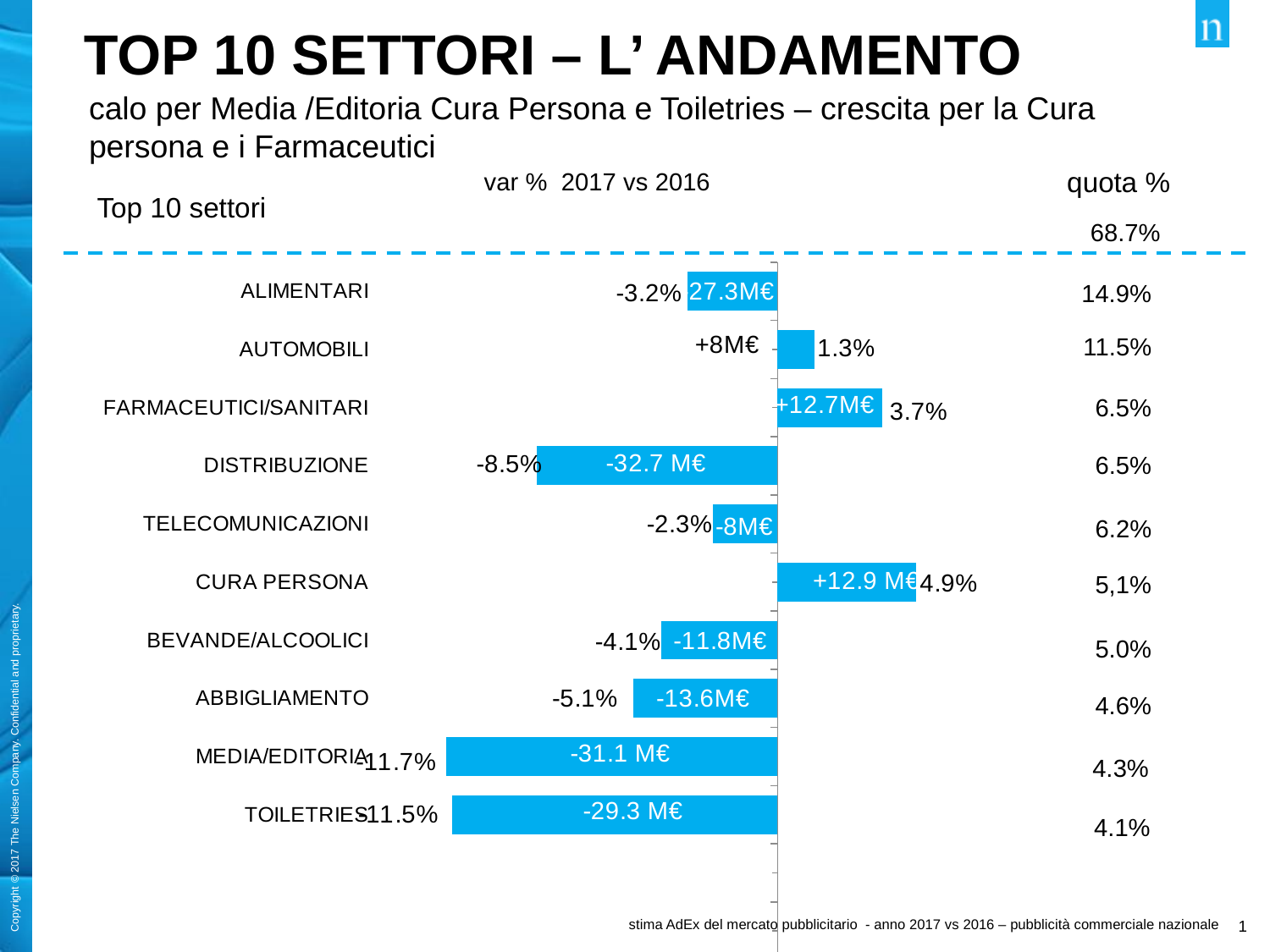
What is the variation in M€ shown for CURA PERSONA? +12.9 M€ Which sector has the highest quota %? ALIMENTARI What type of chart is used to show the variation by sector? bar chart What is the variation in M€ shown for FARMACEUTICI/SANITARI? +12.7M€ What is the variation in M€ shown for DISTRIBUZIONE? -32.7 M€ What is the quota % shown for TELECOMUNICAZIONI? 6.2% How many sectors are plotted in the chart? 10 Which sector has the largest negative variation in M€? DISTRIBUZIONE What percentage variation is shown for ABBIGLIAMENTO? -5.1% What percentage variation is shown for ALIMENTARI? -3.2% Which sector has the largest positive variation in M€? CURA PERSONA